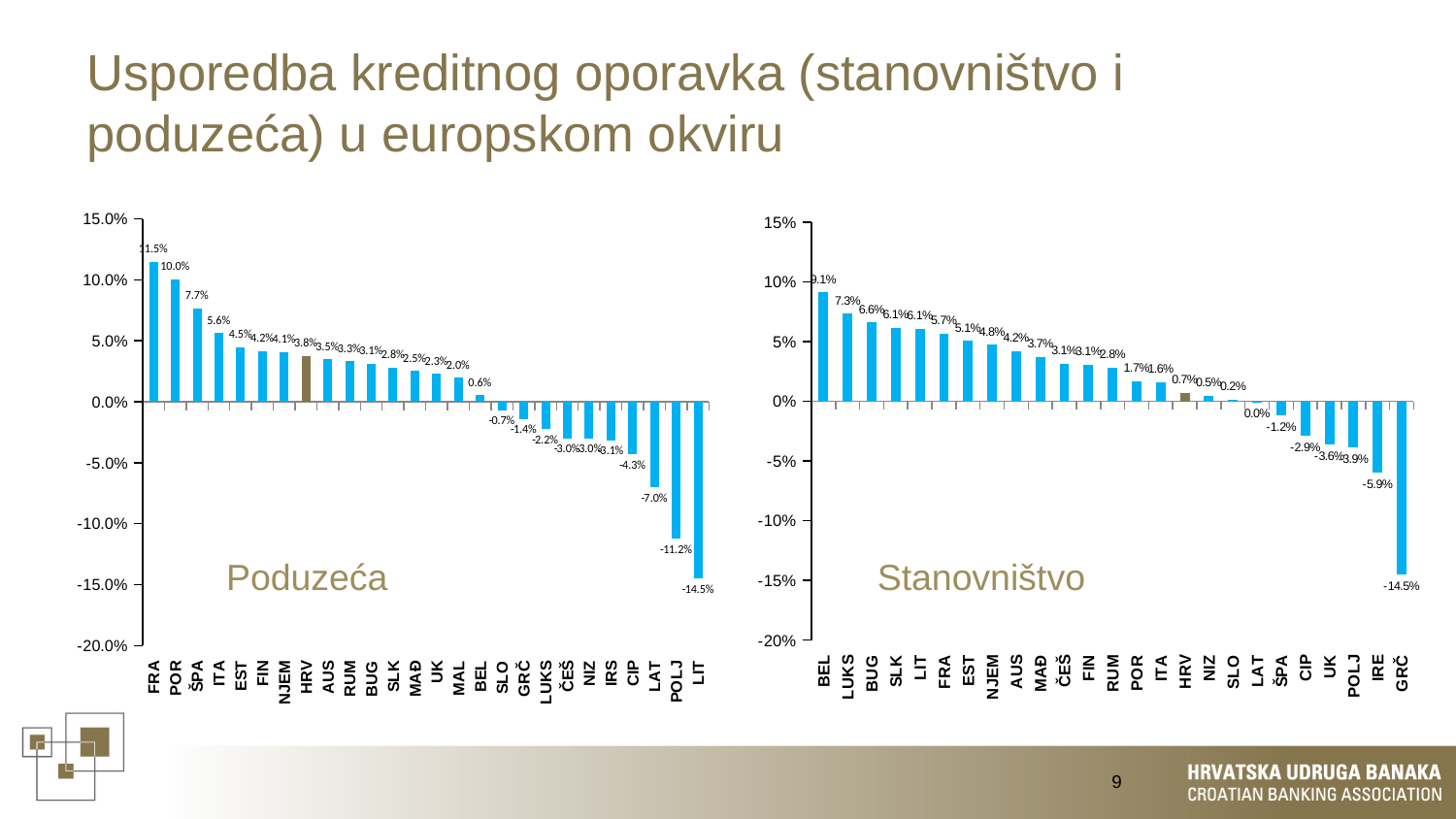
In the Poduzeća chart, what is the difference between the values for FRA and POR? 1.5% In the Poduzeća chart, which is larger, the value for ITA or the value for EST? ITA What kind of chart is the Poduzeća chart? Bar chart In the Stanovništvo chart, which country has the lowest value? GRČ In the Stanovništvo chart, what is the value for BEL? 9.1% In the Stanovništvo chart, is the value for LUKS greater or less than 5%? greater In the Poduzeća chart, what is the value for HRV? 3.8% In the Stanovništvo chart, what is the value for IRE? -5.9% In the Poduzeća chart, do the values rise or fall from left to right along the x axis? Fall In the Stanovništvo chart, what is the value for HRV? 0.7% In the Poduzeća chart, which country has the lowest value? LIT In the Poduzeća chart, what is the value for FRA? 11.5%